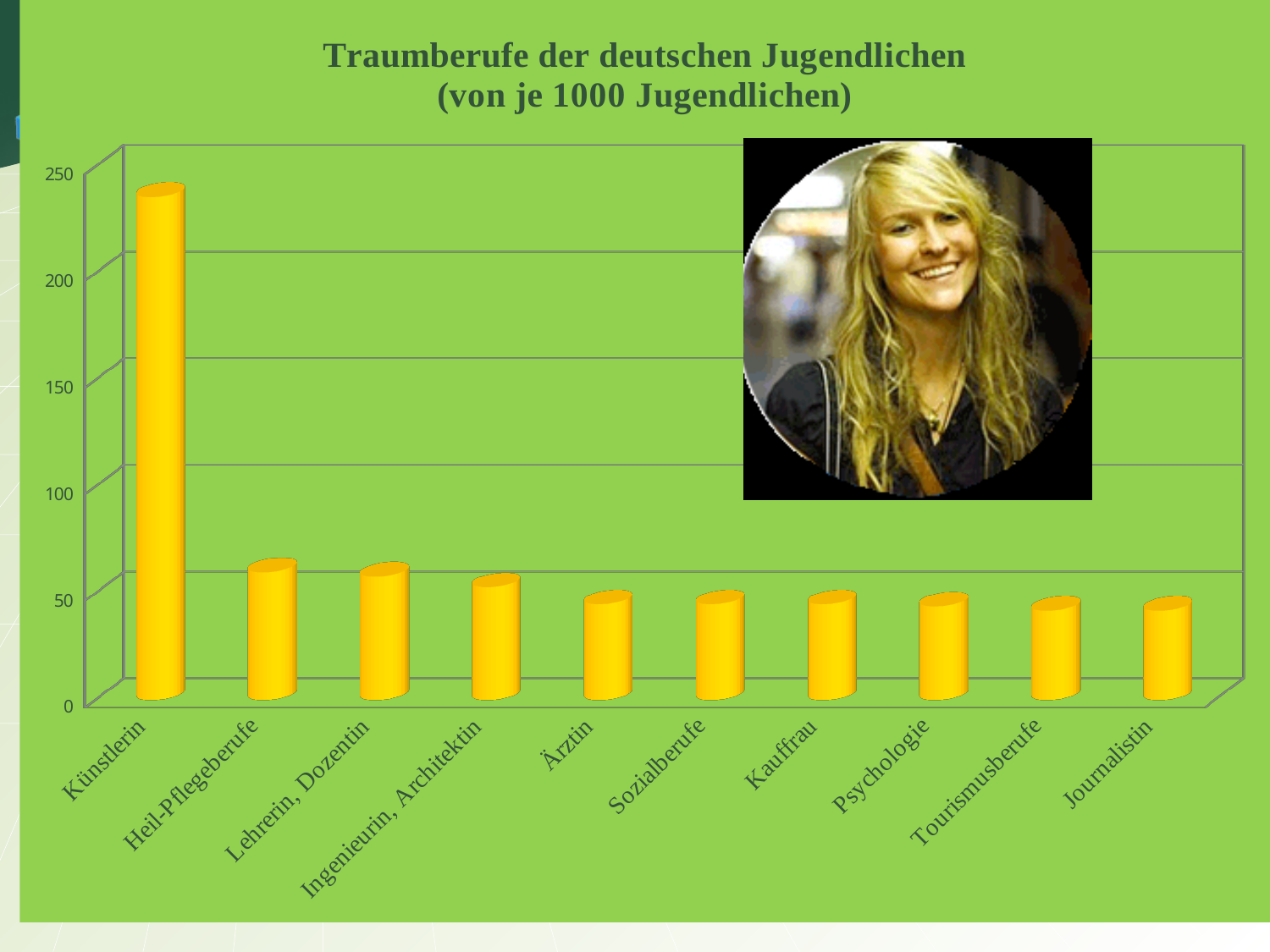
Which is larger, the value for Künstlerin or the value for Heil-Pflegeberufe? Künstlerin What kind of chart is shown on the slide? bar chart What colour are the bars in the chart? yellow Is the value for Ärztin greater or less than 150? less Is the value for Künstlerin greater or less than 200? greater Is the value for Künstlerin greater or less than 250? less Which profession has the highest value? Künstlerin What is the title of the chart? Traumberufe der deutschen Jugendlichen (von je 1000 Jugendlichen) How many categories (professions) are shown on the x axis? 10 Which is larger, the value for Heil-Pflegeberufe or the value for Journalistin? Heil-Pflegeberufe